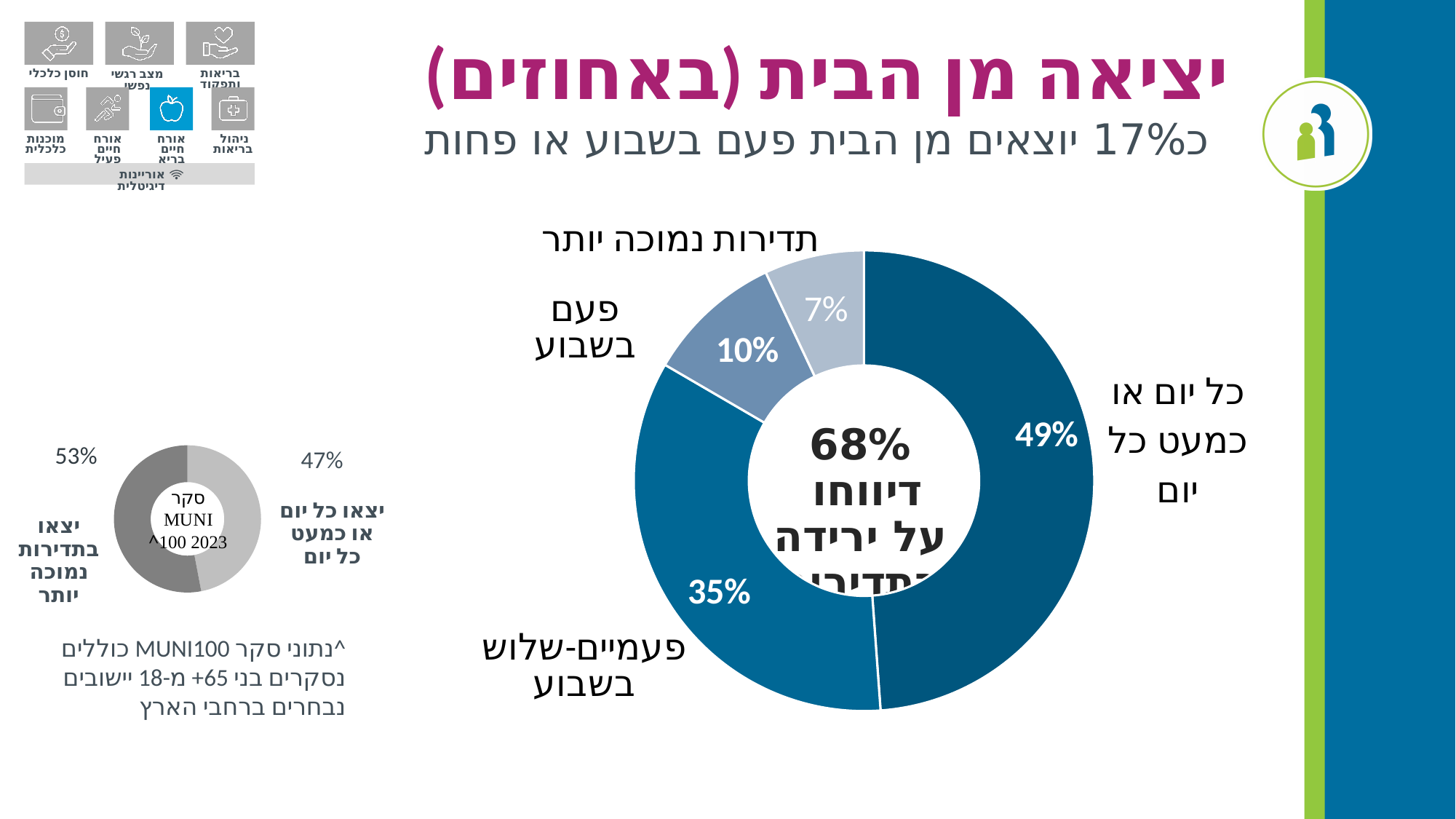
In the large donut chart, what percentage is shown for 'פעם בשבוע'? 10% In the small donut chart on the left (סקר MUNI 100 2023), what percentage is shown for 'יצאו כל יום או כמעט כל יום'? 47% In the small donut chart on the left (סקר MUNI 100 2023), what percentage is shown for 'יצאו בתדירות נמוכה יותר'? 53% In the large donut chart, what percentage is shown for 'כל יום או כמעט כל יום'? 49% What type of chart is the large chart in the centre of the slide? Donut (pie) chart In the large donut chart, how many categories are shown? 4 In the large donut chart, what is the difference between the shares for 'כל יום או כמעט כל יום' and 'פעמיים-שלוש בשבוע'? 14% In the large donut chart, what percentage is shown for 'תדירות נמוכה יותר'? 7% In the large donut chart, what percentage is shown for 'פעמיים-שלוש בשבוע'? 35% In the large donut chart, which category has the largest share? כל יום או כמעט כל יום What percentage is printed in the centre of the large donut chart? 68% In the large donut chart, which category has the smallest share? תדירות נמוכה יותר